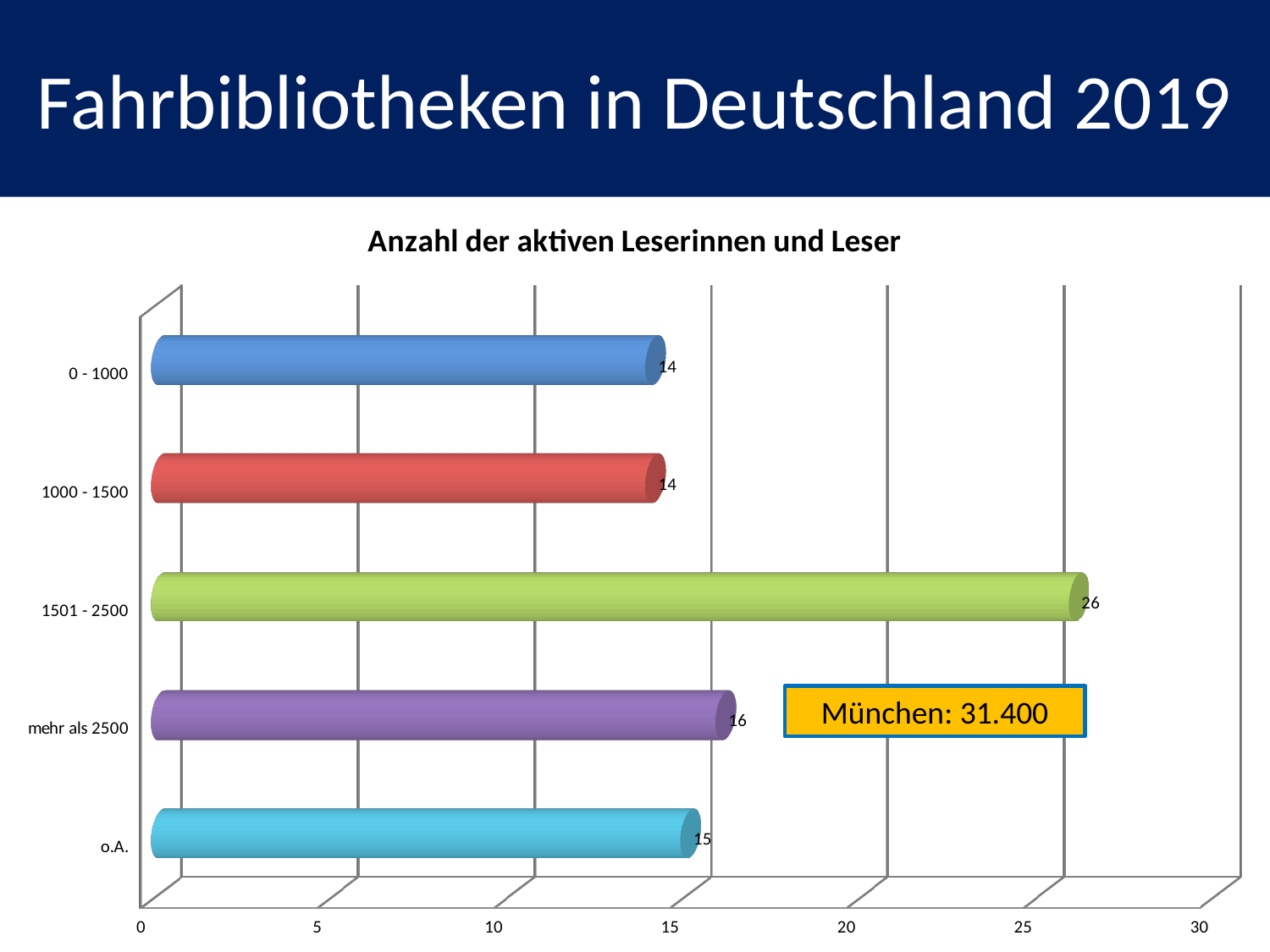
How many categories are shown in the chart? 5 Which category has the highest value? 1501 - 2500 What is the title of the chart? Anzahl der aktiven Leserinnen und Leser What kind of chart is shown on the slide? bar chart What is the value for the category "1501 - 2500"? 26 What is the difference between the values for "o.A." and "1000 - 1500"? 1 What is the value for the category "o.A."? 15 Which is larger, the value for "mehr als 2500" or the value for "o.A."? mehr als 2500 What is the value for the category "mehr als 2500"? 16 What is the difference between the values for "1501 - 2500" and "mehr als 2500"? 10 What is the value for the category "0 - 1000"? 14 Is the value for "1501 - 2500" greater or less than 25? greater